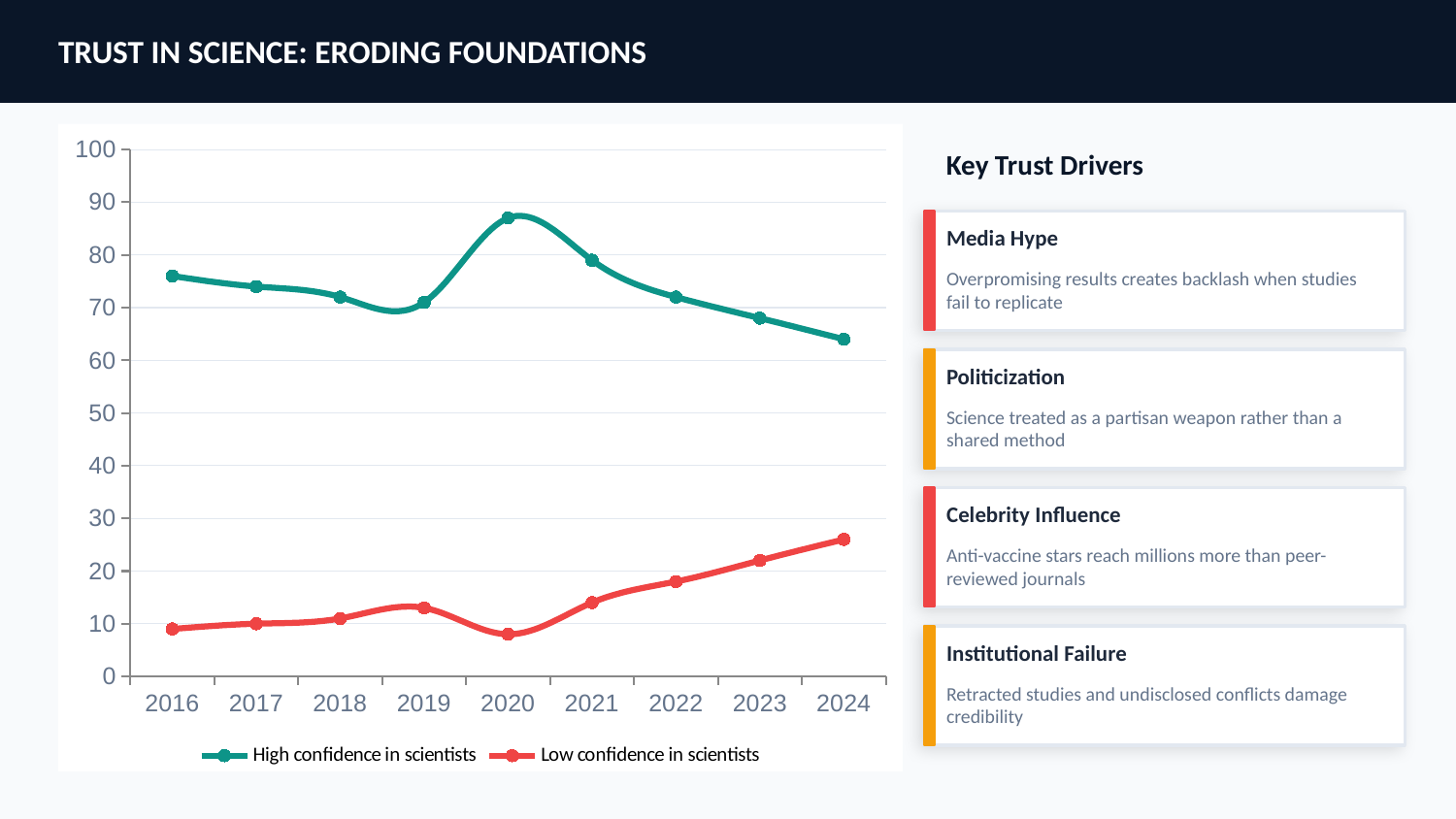
Which is larger: 'High confidence in scientists' in 2016 or in 2020? 2020 Is the value for 'High confidence in scientists' in 2024 greater or less than 70? less Is the value for 'High confidence in scientists' in 2020 greater or less than 80? greater In which year does the 'High confidence in scientists' series reach its lowest value? 2024 What colour is the line for 'High confidence in scientists'? Teal (green) In which year does the 'High confidence in scientists' series reach its highest value? 2020 Is the value for 'Low confidence in scientists' in 2024 greater or less than 20? greater What kind of chart is shown on the slide? Line chart Does the 'Low confidence in scientists' series rise or fall from 2020 to 2024? Rise How many years are plotted along the x axis of the chart? 9 In which year does the 'Low confidence in scientists' series reach its highest value? 2024 How many series does the chart legend list? 2